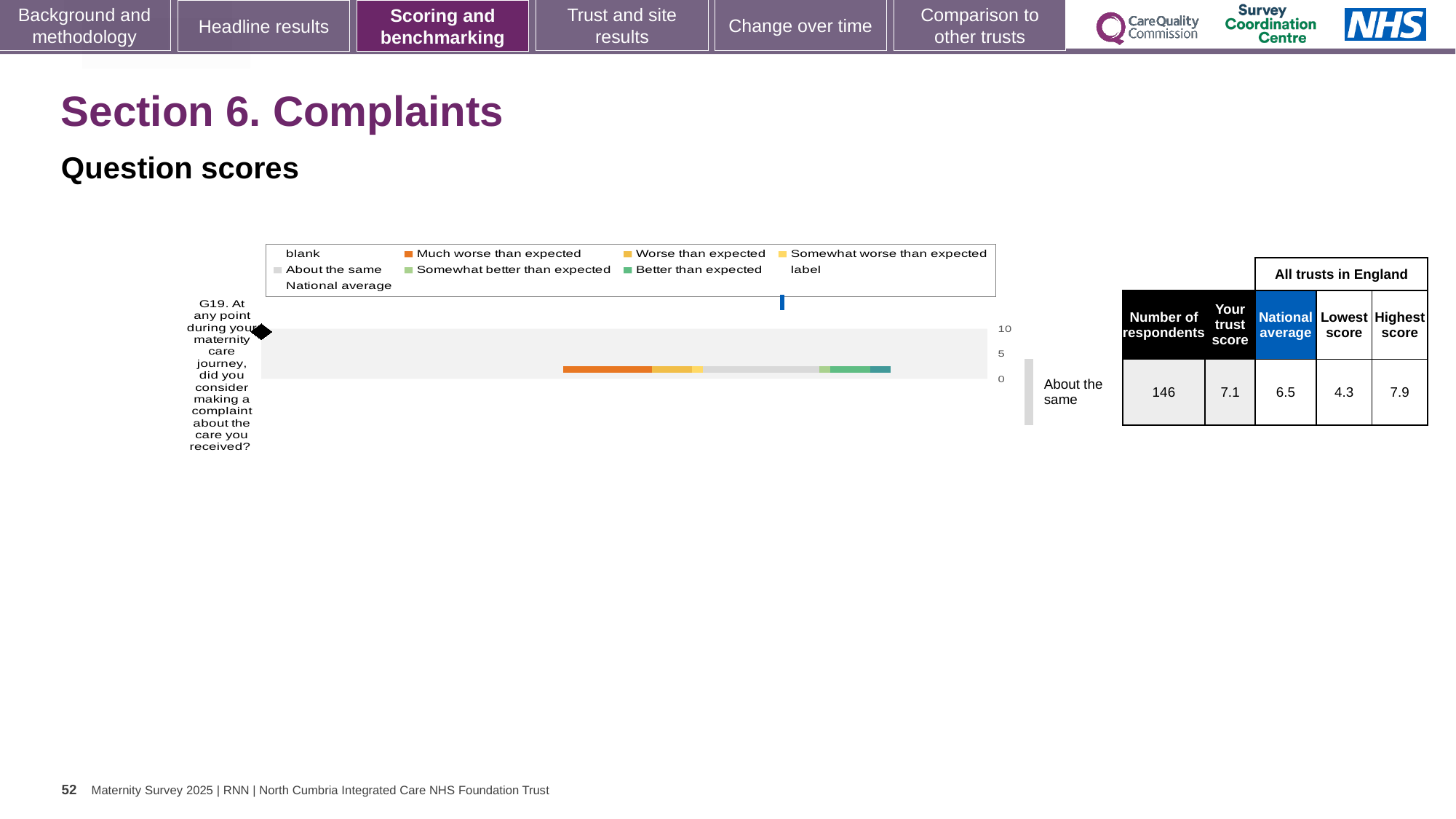
What is the difference between the highest score and the lowest score for question G19? 3.6 By how much does the trust score exceed the national average for question G19? 0.6 What is the trust score for question G19 about considering making a complaint? 7.1 What benchmark category is shown next to the chart for question G19? About the same Is the trust score for question G19 greater or less than 5? greater What is the highest score among all trusts in England for question G19? 7.9 How many survey questions are plotted on the chart? 1 What is the national average score for question G19? 6.5 What is the lowest score among all trusts in England for question G19? 4.3 What kind of chart is used to show the G19 question score? Bar chart How many respondents answered question G19? 146 Which is larger for question G19, the trust score or the national average? Trust score